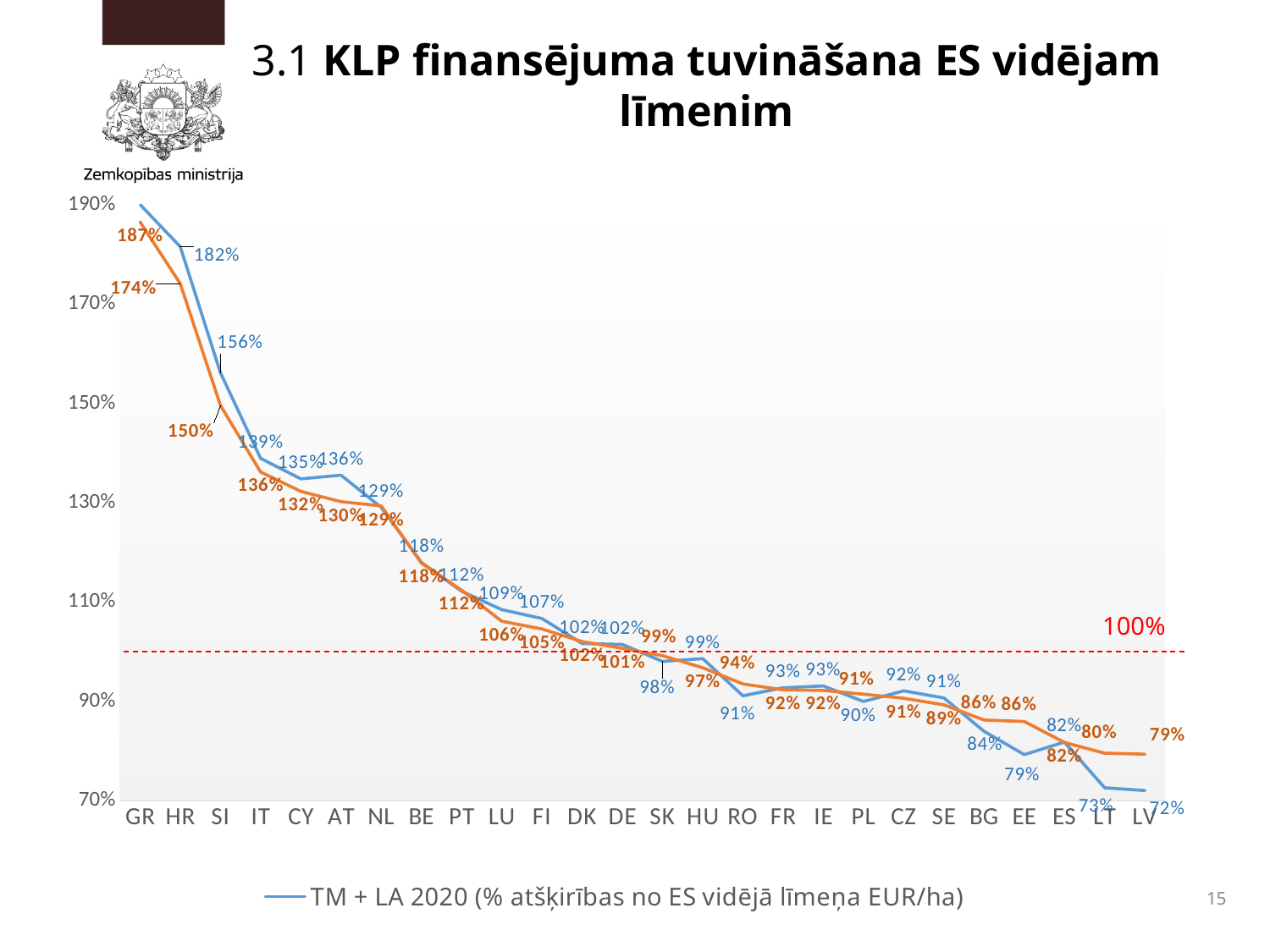
Which country has the lowest value on the blue TM + LA 2020 line? LV Which country has the highest value on the orange line? GR How many countries are shown on the x axis? 26 For BG, which is larger: the blue line value or the orange line value? The orange line value (86%) What is the value of the blue TM + LA 2020 line for LV? 72% What is the value of the blue TM + LA 2020 line for HR? 182% What kind of chart is shown on the slide? Line chart What is the value of the orange line for SI? 150% What is the value of the orange line for LV? 79% Do the values rise or fall moving from GR to LV along the x axis? Fall What is the difference between the blue line value (182%) and the orange line value (174%) for HR? 8 percentage points Is the value of the blue line for GR greater or less than 180%? greater